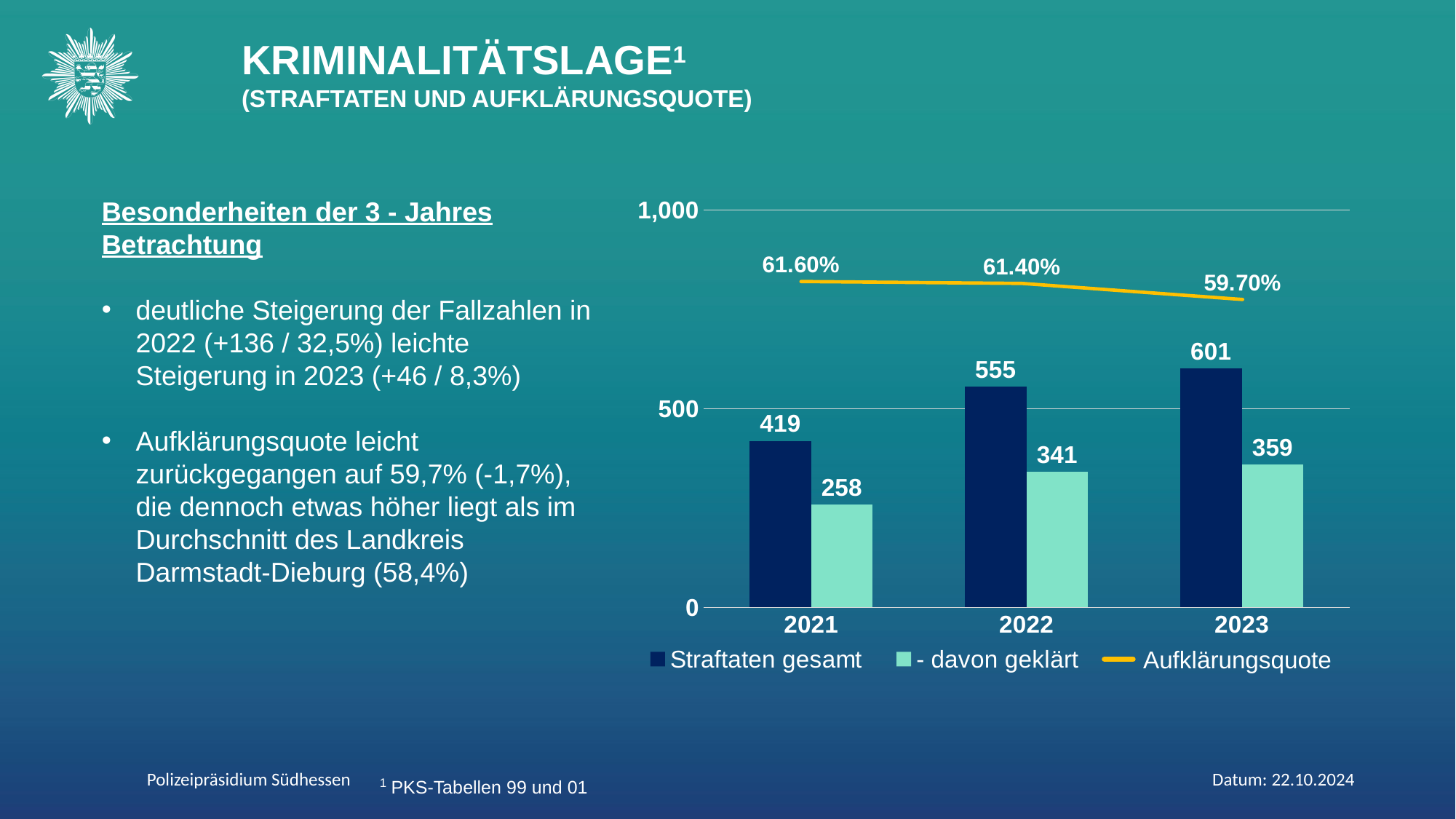
What is the value of '- davon geklärt' for 2021? 258 How many years are shown on the x axis of the chart? 3 What is the Aufklärungsquote for 2023? 59.70% How many series does the chart legend list? 3 Which is larger: '- davon geklärt' in 2022 or Straftaten gesamt in 2021? Straftaten gesamt in 2021 What is the value of Straftaten gesamt for 2022? 555 Which year has the lowest value for '- davon geklärt'? 2021 Which series is drawn as a yellow line in the chart? Aufklärungsquote Is the value for Straftaten gesamt in 2021 greater or less than 500? less What is the difference between Straftaten gesamt in 2023 and 2022? 46 Does the Aufklärungsquote rise or fall from 2021 to 2023? fall Which year has the highest value for Straftaten gesamt? 2023